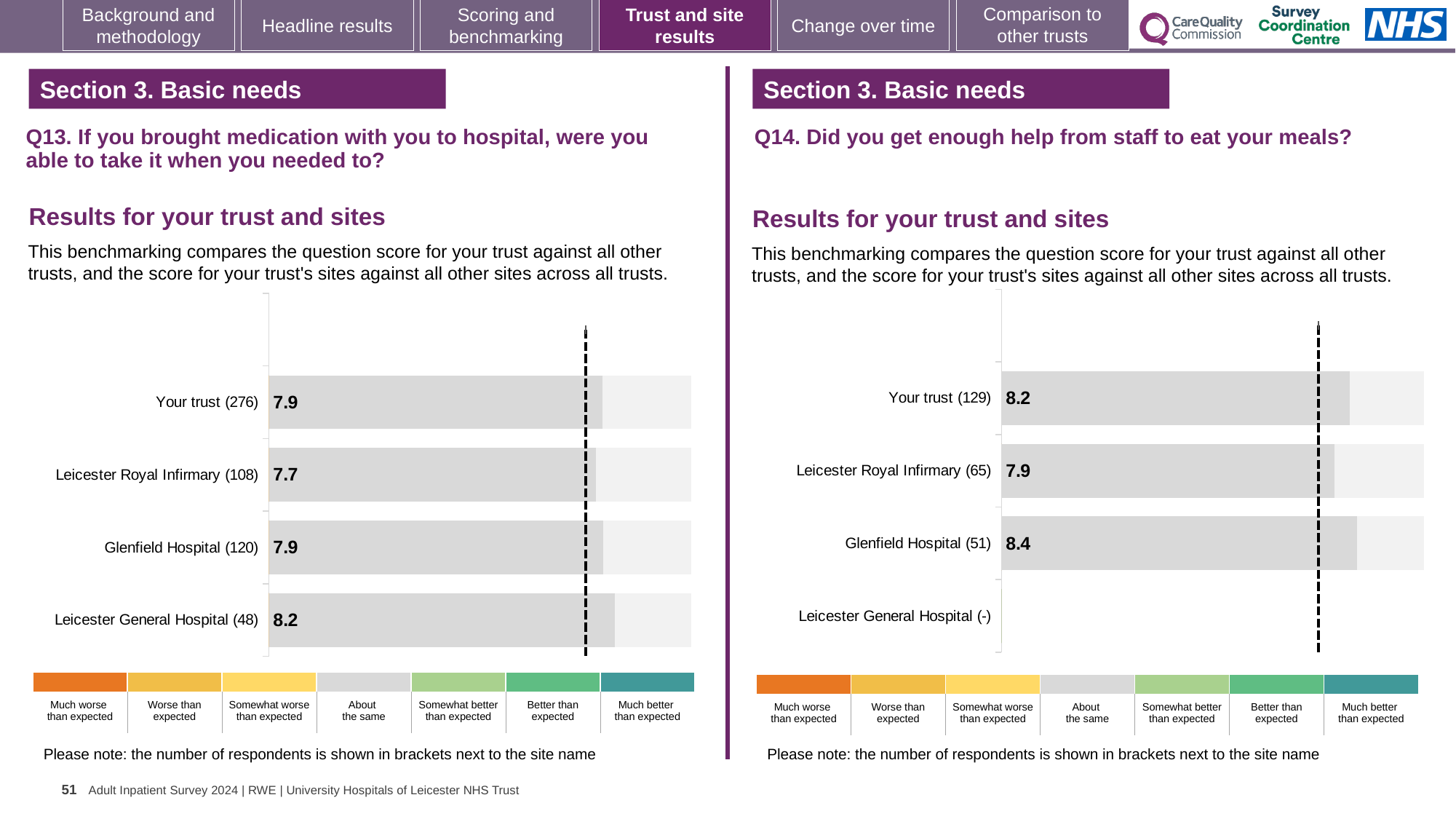
In the Q13 chart on the left, what is the score for Leicester Royal Infirmary? 7.7 What kind of chart is the Q13 chart on the left? Bar chart In the Q14 chart on the right, what is the score for Your trust? 8.2 In the Q14 chart on the right, which row has the highest score? Glenfield Hospital How many respondents are shown in brackets for Your trust in the Q13 chart on the left? 276 In the Q14 chart on the right, which is larger: the score for Your trust or the score for Leicester Royal Infirmary? Your trust In the Q13 chart on the left, what is the score for Leicester General Hospital? 8.2 In the Q14 chart on the right, what is the score for Glenfield Hospital? 8.4 In the Q13 chart on the left, which site or trust row has the lowest score? Leicester Royal Infirmary In the Q13 chart on the left, which site or trust row has the highest score? Leicester General Hospital In the Q14 chart on the right, what is the difference between the scores for Glenfield Hospital and Leicester Royal Infirmary? 0.5 In the Q13 chart on the left, what is the difference between the scores for Leicester General Hospital and Leicester Royal Infirmary? 0.5